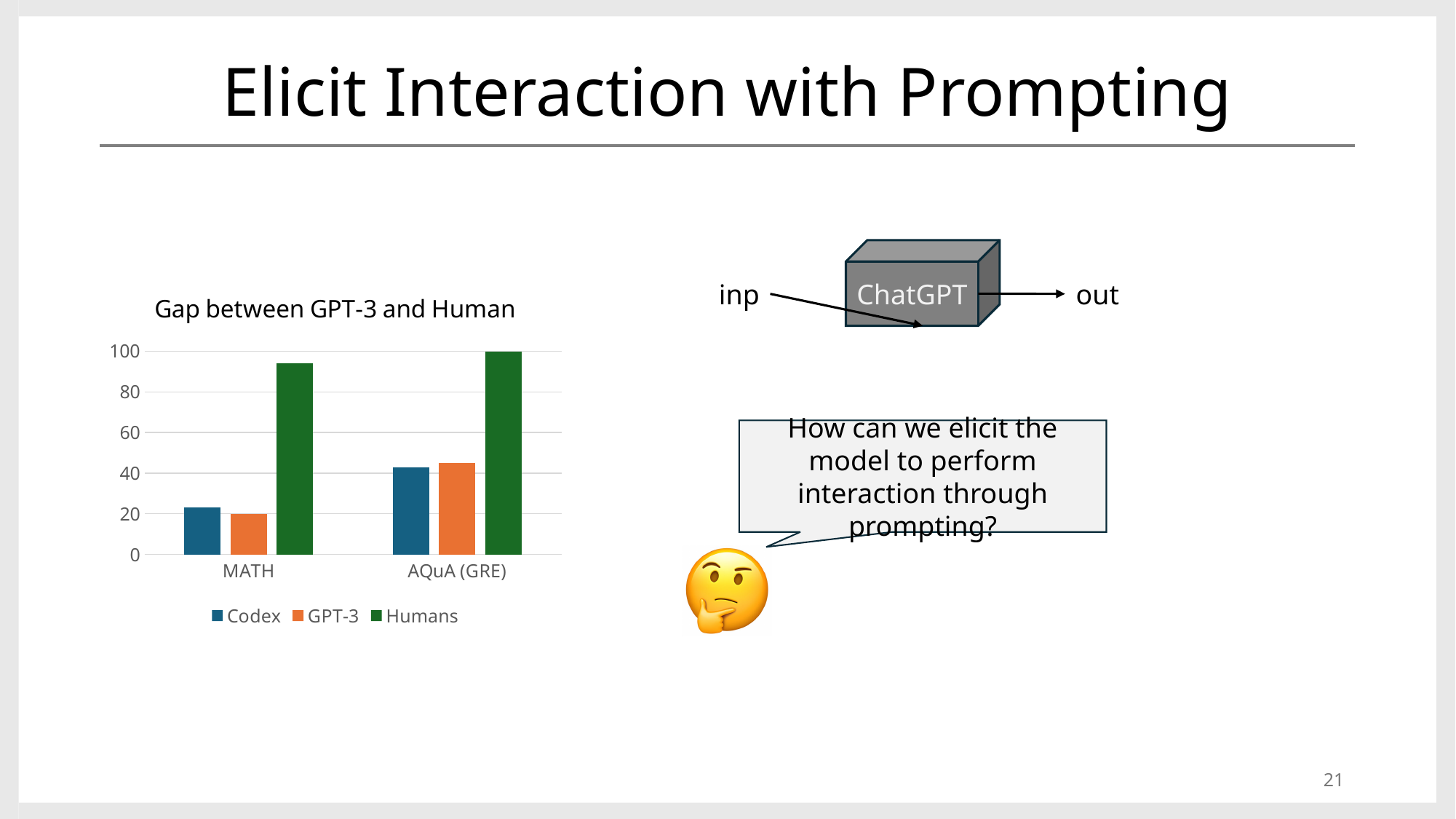
Which series has the highest value for AQuA (GRE)? Humans Which colour represents the Humans series in the chart? green Is the value for GPT-3 on AQuA (GRE) greater or less than 40? greater What kind of chart is shown on the slide? bar chart Is the value for Codex on MATH greater or less than 40? less What is the value for Humans on AQuA (GRE)? 100 Does the value for Codex rise or fall from MATH to AQuA (GRE)? rise Is the value for Humans on MATH greater or less than 80? greater Which series has the highest value for MATH? Humans What is the title of the chart? Gap between GPT-3 and Human How many series does the chart's legend list? 3 How many categories are shown on the x axis of the chart? 2